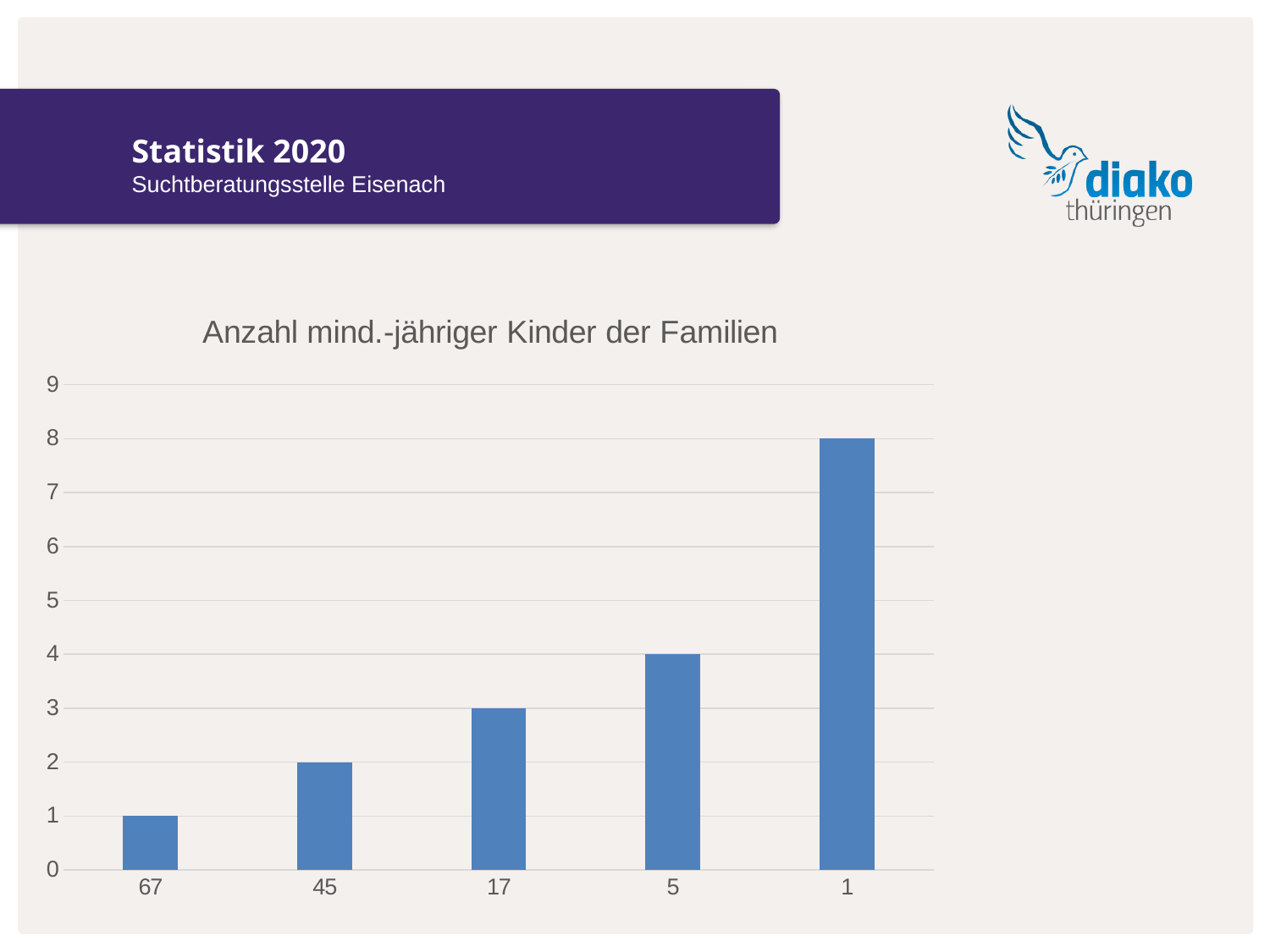
How many bars does the chart have? 5 Do the bar values rise or fall from left to right along the x axis? rise What is the title of the chart? Anzahl mind.-jähriger Kinder der Familien Which category has the lowest bar? 67 What is the value of the bar for category 17? 3 Which category has the highest bar? 1 What is the value of the bar for category 67? 1 What kind of chart is shown on the slide? bar chart What is the value of the bar for category 1? 8 What is the value of the bar for category 45? 2 What is the value of the bar for category 5? 4 What is the difference between the values for category 1 and category 5? 4